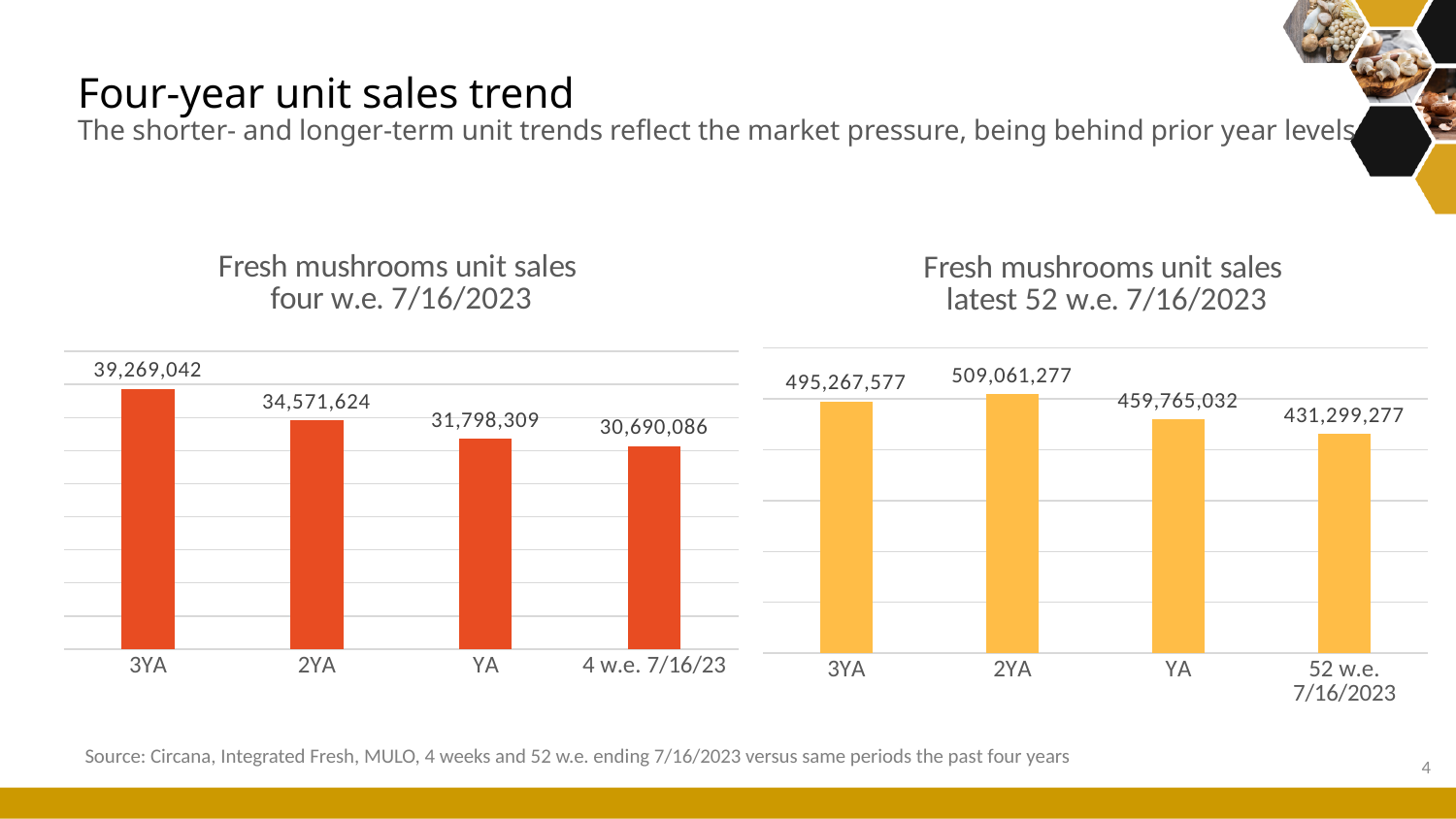
In the 'Fresh mushrooms unit sales latest 52 w.e. 7/16/2023' chart, which is larger, the value for 3YA or the value for 2YA? 2YA How many bars are in the 'Fresh mushrooms unit sales four w.e. 7/16/2023' chart? 4 In the 'Fresh mushrooms unit sales four w.e. 7/16/2023' chart, what is the value for 4 w.e. 7/16/23? 30,690,086 In the 'Fresh mushrooms unit sales latest 52 w.e. 7/16/2023' chart, what is the difference between the YA value and the 52 w.e. 7/16/2023 value? 28,465,755 In the 'Fresh mushrooms unit sales four w.e. 7/16/2023' chart, what is the difference between the 3YA value and the 4 w.e. 7/16/23 value? 8,578,956 In the 'Fresh mushrooms unit sales latest 52 w.e. 7/16/2023' chart, what is the value for 52 w.e. 7/16/2023? 431,299,277 In the 'Fresh mushrooms unit sales latest 52 w.e. 7/16/2023' chart, which category has the highest value? 2YA In the 'Fresh mushrooms unit sales four w.e. 7/16/2023' chart, which category has the lowest value? 4 w.e. 7/16/23 In the 'Fresh mushrooms unit sales four w.e. 7/16/2023' chart, what is the value for 3YA? 39,269,042 In the 'Fresh mushrooms unit sales four w.e. 7/16/2023' chart, do the values rise or fall from 3YA to 4 w.e. 7/16/23? Fall In the 'Fresh mushrooms unit sales latest 52 w.e. 7/16/2023' chart, what is the value for YA? 459,765,032 What type of chart is the 'Fresh mushrooms unit sales latest 52 w.e. 7/16/2023' chart? Bar chart